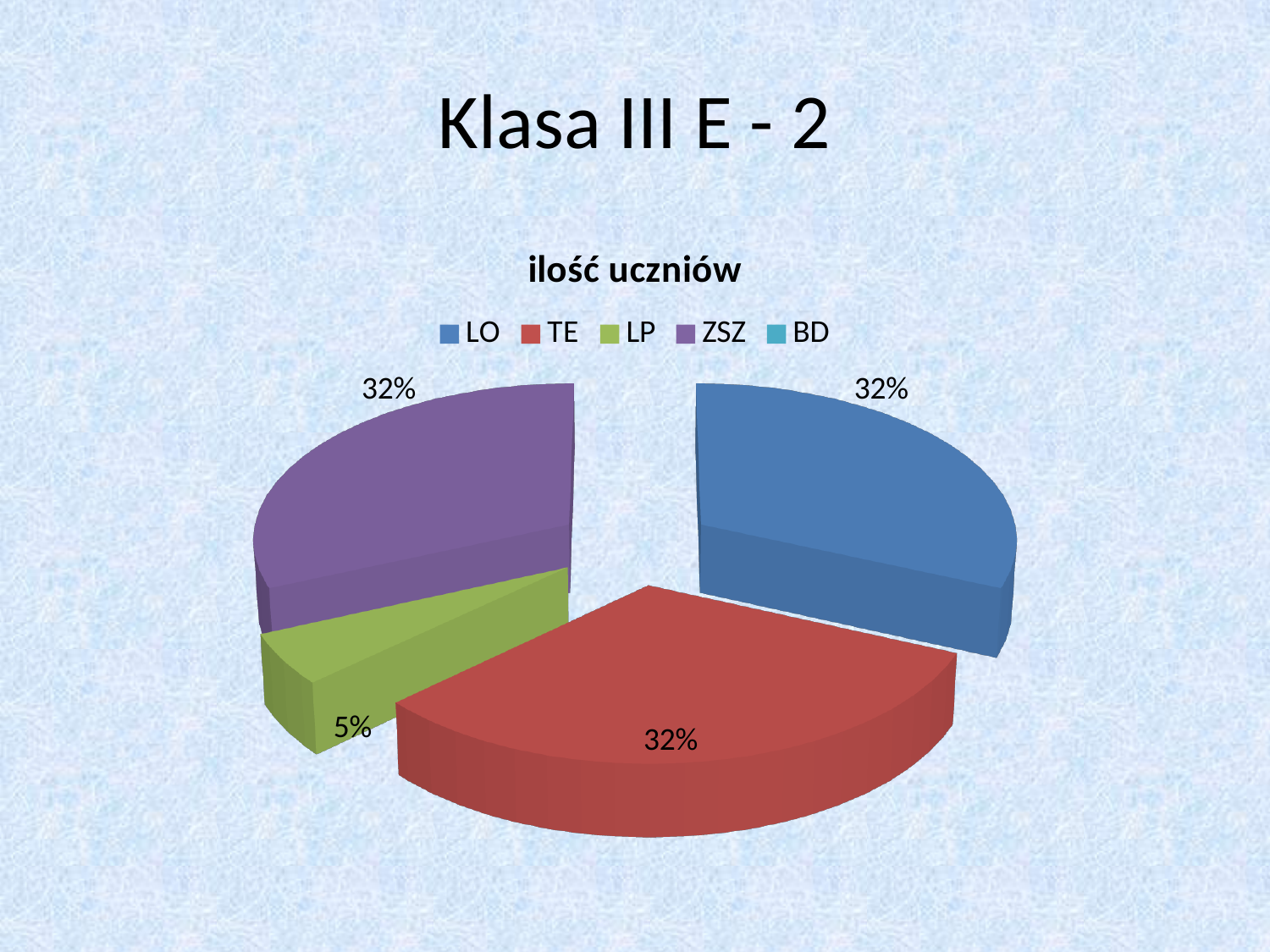
What is the title of the chart? ilość uczniów What colour is the slice for TE? Red Which is larger, the share for LO or the share for LP? LO What share of the pie does LP represent? 5% Which category has the smallest slice of the pie? LP What share of the pie does TE represent? 32% What share of the pie does LO represent? 32% What kind of chart is shown on the slide? Pie chart What share of the pie does ZSZ represent? 32% How many slices with a percentage label are visible in the pie? 4 How many categories does the legend list? 5 What is the difference in percentage points between the share for ZSZ and the share for LP? 27